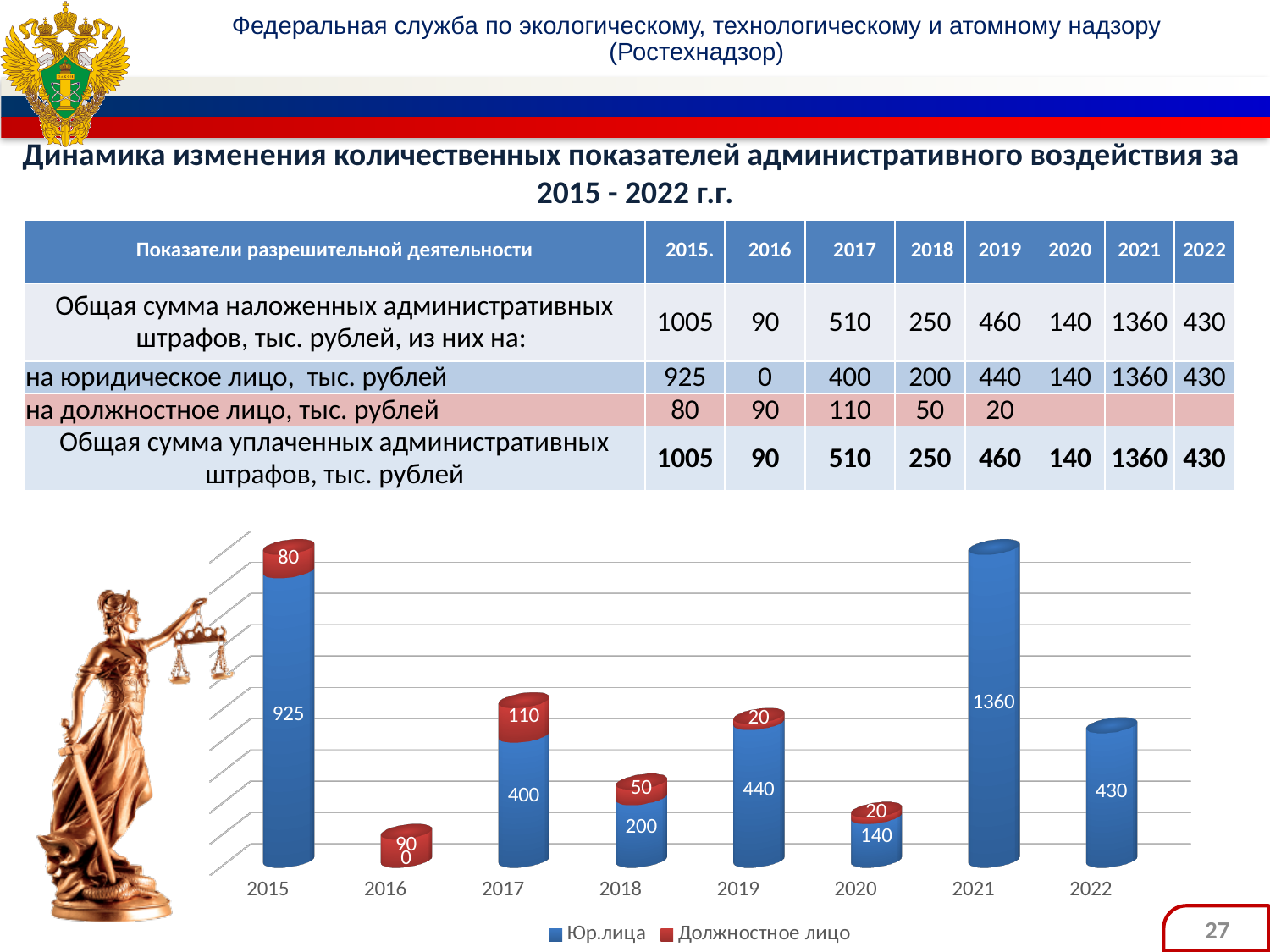
Which year has the highest value for Юр.лица? 2021 What is the value for Должностное лицо in 2017? 110 Which colour represents Должностное лицо in the chart? red What is the value for Юр.лица in 2021? 1360 How many years are shown on the x axis of the chart? 8 What is the total of the stacked bar for 2015? 1005 How many series does the chart legend list? 2 What is the difference between the Юр.лица values for 2015 and 2022? 495 Which is larger, the Юр.лица value for 2017 or for 2018? 2017 What is the value for Юр.лица in 2019? 440 What kind of chart is shown on the slide? bar chart Which year has the lowest value for Юр.лица? 2016